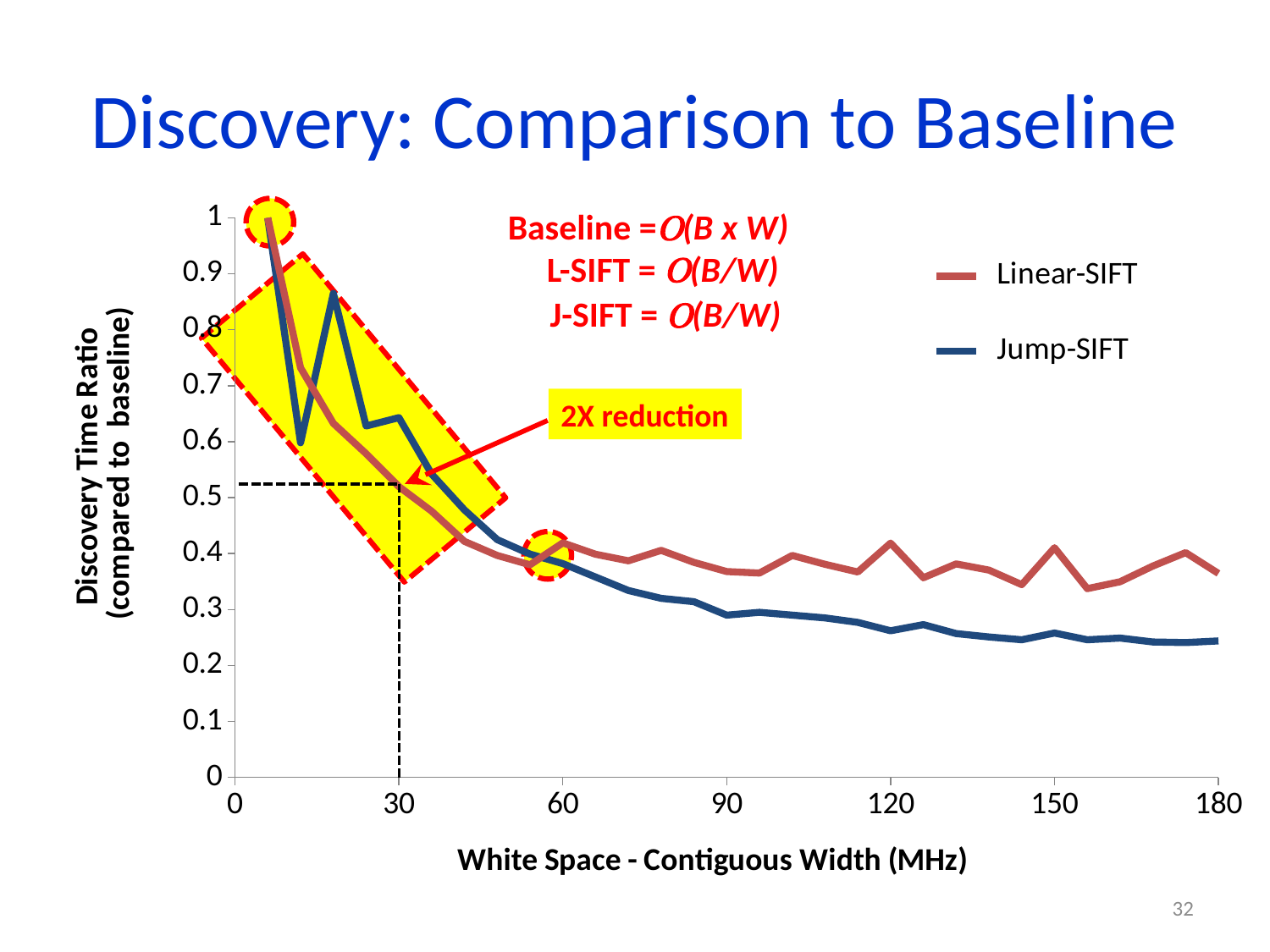
What are the two series named in the legend? Linear-SIFT and Jump-SIFT How many series does the legend list? 2 What kind of chart is shown on the slide? line chart Is the Linear-SIFT value at 150 MHz greater or less than 0.3? greater At 120 MHz, which series has the lower discovery time ratio, Linear-SIFT or Jump-SIFT? Jump-SIFT At 180 MHz, which series has the higher discovery time ratio, Linear-SIFT or Jump-SIFT? Linear-SIFT What is the label of the x axis? White Space - Contiguous Width (MHz) Overall, does the Linear-SIFT discovery time ratio rise or fall as the contiguous width increases from 0 to 180 MHz? fall Is the Jump-SIFT value at 120 MHz greater or less than 0.3? less Is the Linear-SIFT value at 180 MHz greater or less than 0.3? greater Overall, does the Jump-SIFT discovery time ratio rise or fall as the contiguous width increases from 0 to 180 MHz? fall